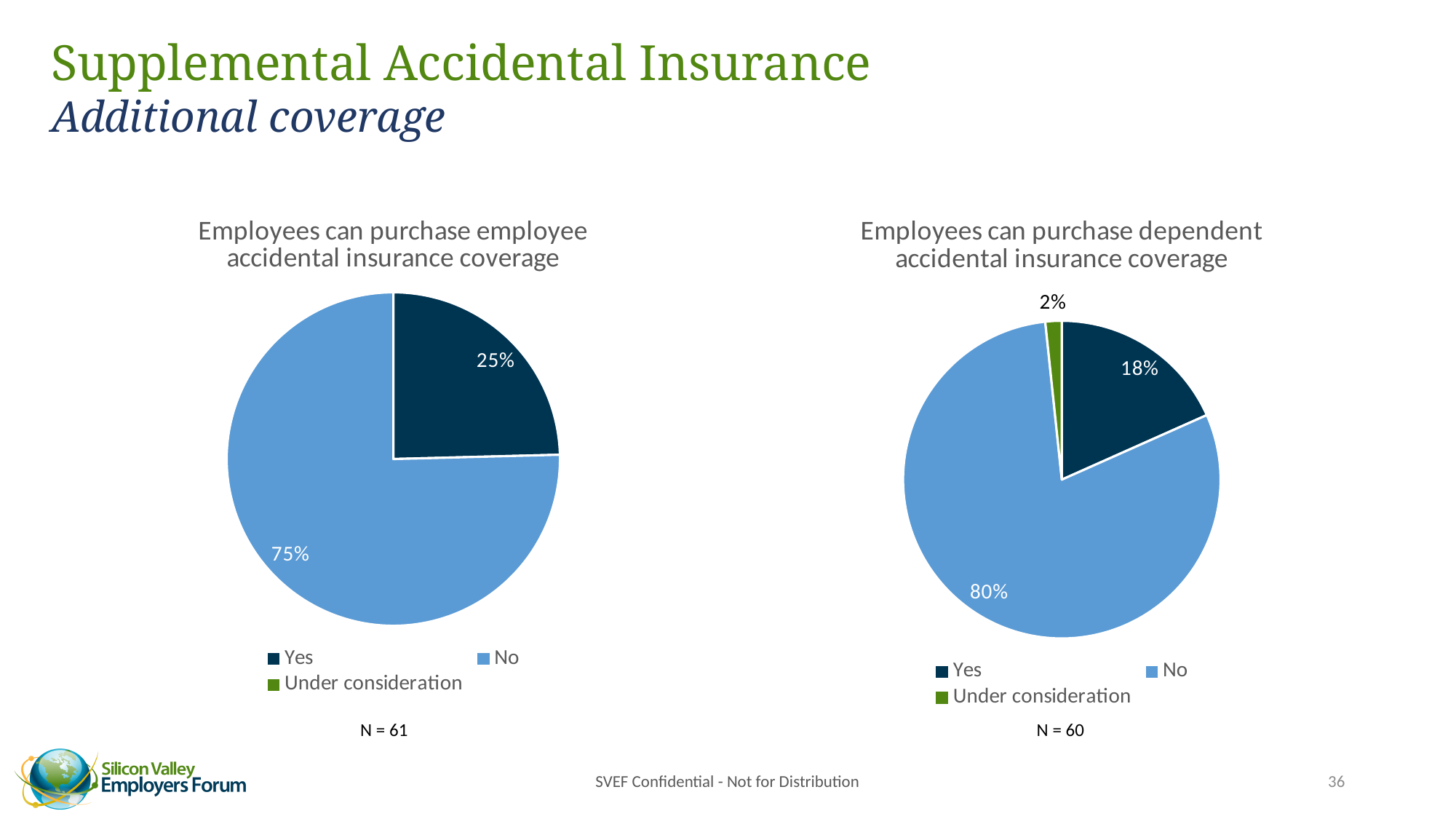
In the 'Employees can purchase dependent accidental insurance coverage' chart, which category has the smallest slice? Under consideration What type of chart is used on this slide? Pie chart In the 'Employees can purchase employee accidental insurance coverage' chart, what share of the pie is 'Yes'? 25% In the 'Employees can purchase dependent accidental insurance coverage' chart, what share of the pie is 'No'? 80% In the 'Employees can purchase dependent accidental insurance coverage' chart, what share of the pie is 'Yes'? 18% In the 'Employees can purchase employee accidental insurance coverage' chart, what is the difference in percentage points between 'No' and 'Yes'? 50 How many entries does the legend of the 'Employees can purchase dependent accidental insurance coverage' chart list? 3 In the 'Employees can purchase dependent accidental insurance coverage' chart, which category has the largest slice? No Which chart has the larger 'Yes' share, the employee coverage chart on the left or the dependent coverage chart on the right? The employee coverage chart on the left In the 'Employees can purchase dependent accidental insurance coverage' chart, what is the difference in percentage points between 'No' and 'Yes'? 62